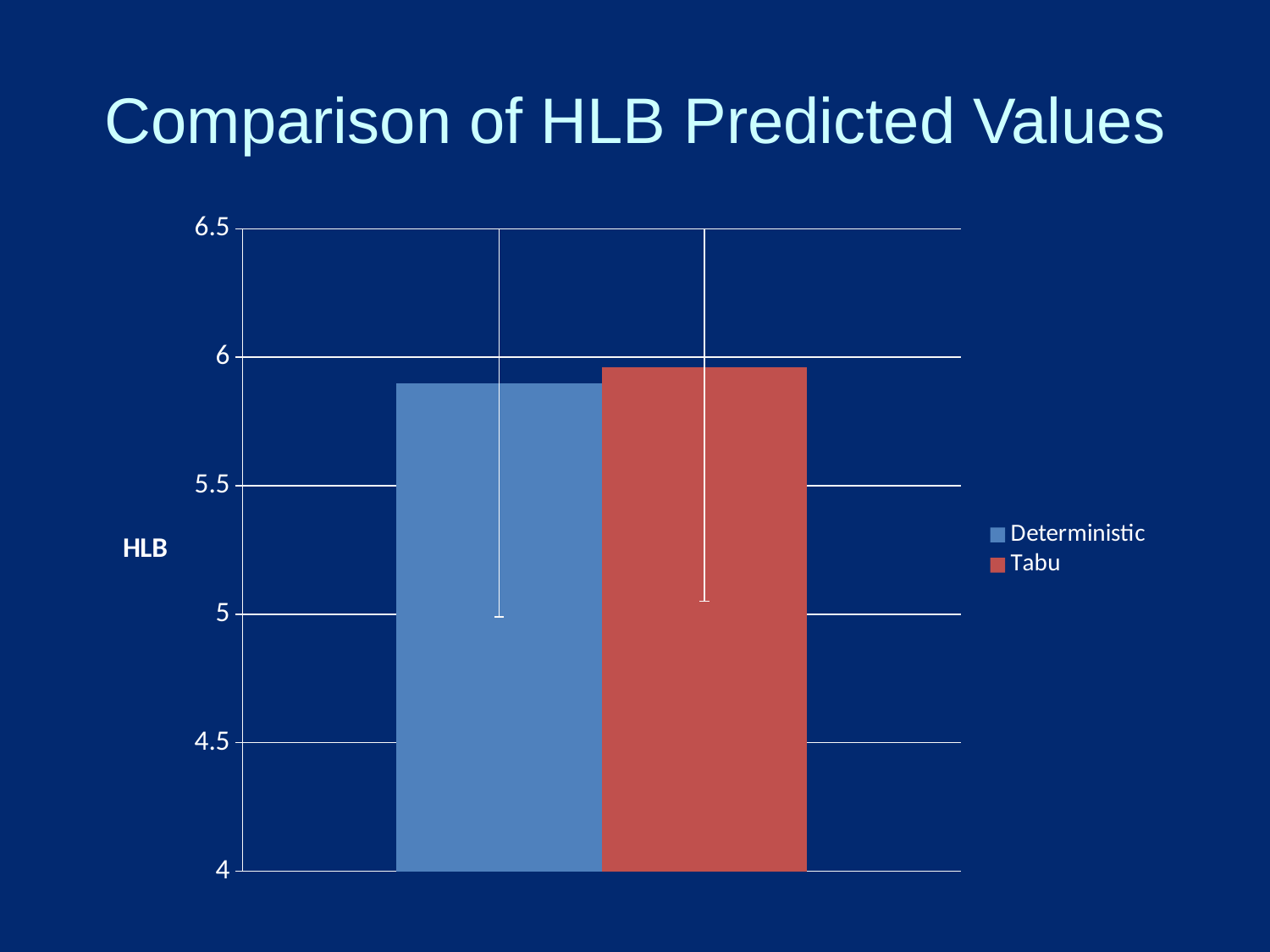
How many bars are plotted in the chart? 2 Which series has the higher bar, Deterministic or Tabu? Tabu Is the value for Tabu greater or less than 5.5? greater What kind of chart is shown on the slide? bar chart How many series does the legend list? 2 What is the lowest value shown on the vertical axis? 4 Is the value for Deterministic greater or less than 6? less What is the title of the chart? Comparison of HLB Predicted Values Is the value for Tabu greater or less than 6? less What is the label on the vertical axis? HLB